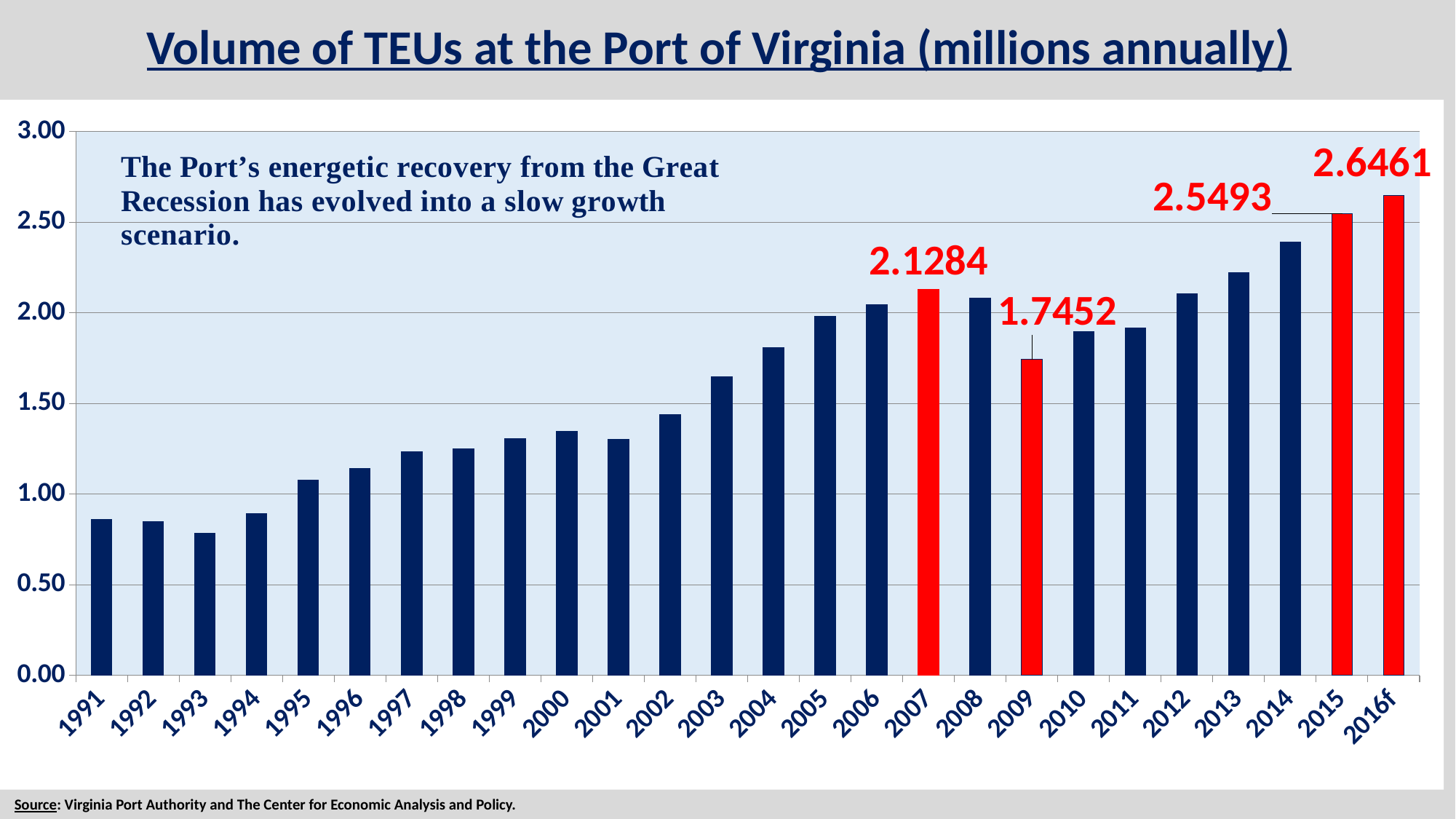
What is the volume of TEUs for 2015? 2.5493 What is the volume of TEUs for 2007? 2.1284 Is the value for 2014 greater or less than 2.00? greater What is the volume of TEUs for 2009? 1.7452 What is the difference between the 2007 value and the 2009 value? 0.3832 What is the difference between the 2016f value and the 2015 value? 0.0968 Which year has the lowest volume of TEUs? 1993 What is the volume of TEUs for 2016f? 2.6461 What type of chart is shown on the slide? Bar chart How many years are shown on the x axis? 26 Which year has the highest volume of TEUs? 2016f What is the title of the chart? Volume of TEUs at the Port of Virginia (millions annually)